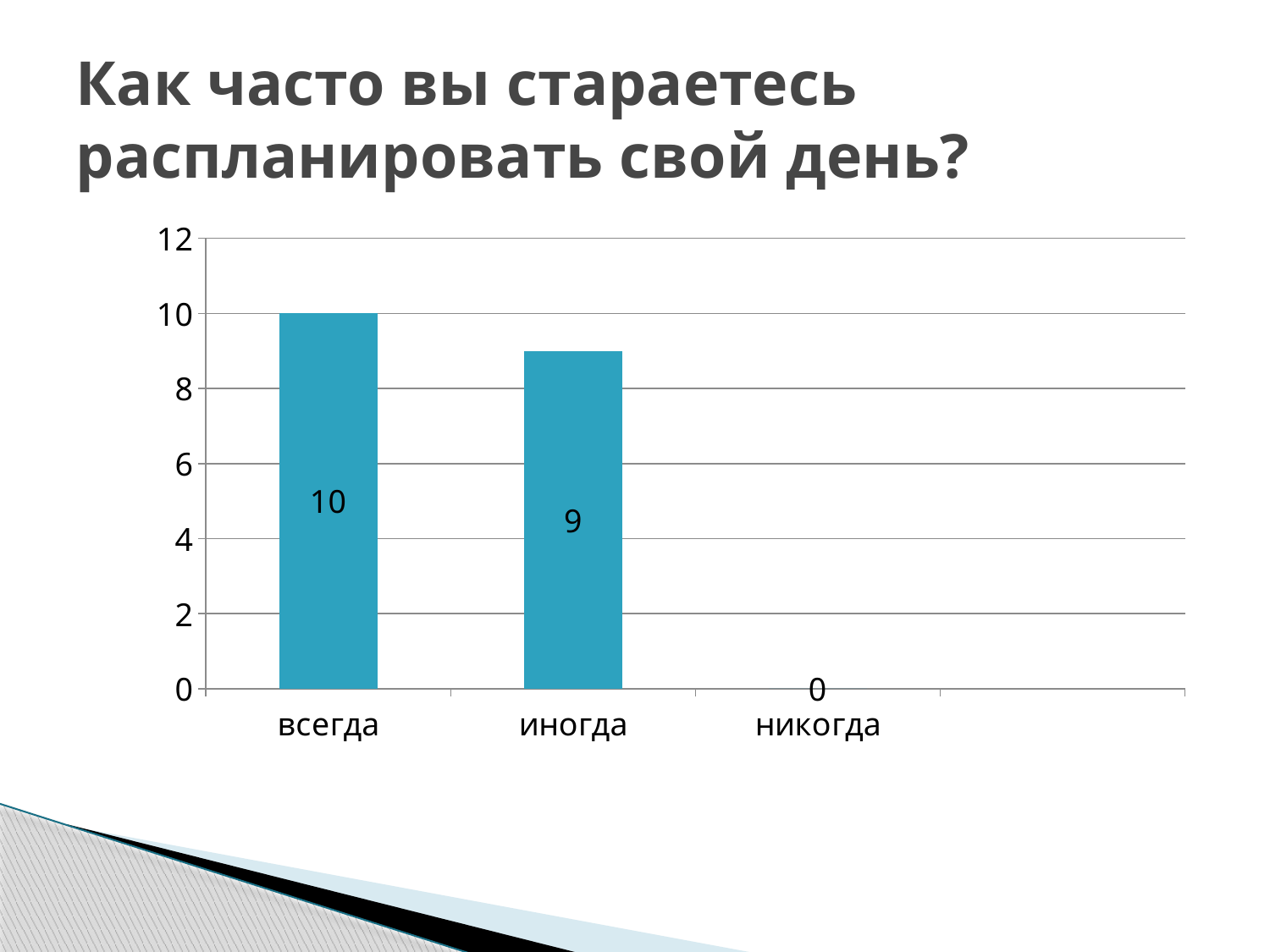
Which category has the highest value? всегда Is the value for иногда greater or less than 8? greater What is the title of the slide? Как часто вы стараетесь распланировать свой день? What is the value for всегда? 10 What is the value for иногда? 9 What is the difference between the values for иногда and никогда? 9 What is the difference between the values for всегда and иногда? 1 Which category has the lowest value? никогда How many categories are shown on the x axis? 3 What kind of chart is shown on the slide? bar chart What is the value for никогда? 0 Which is larger, the value for всегда or the value for иногда? всегда